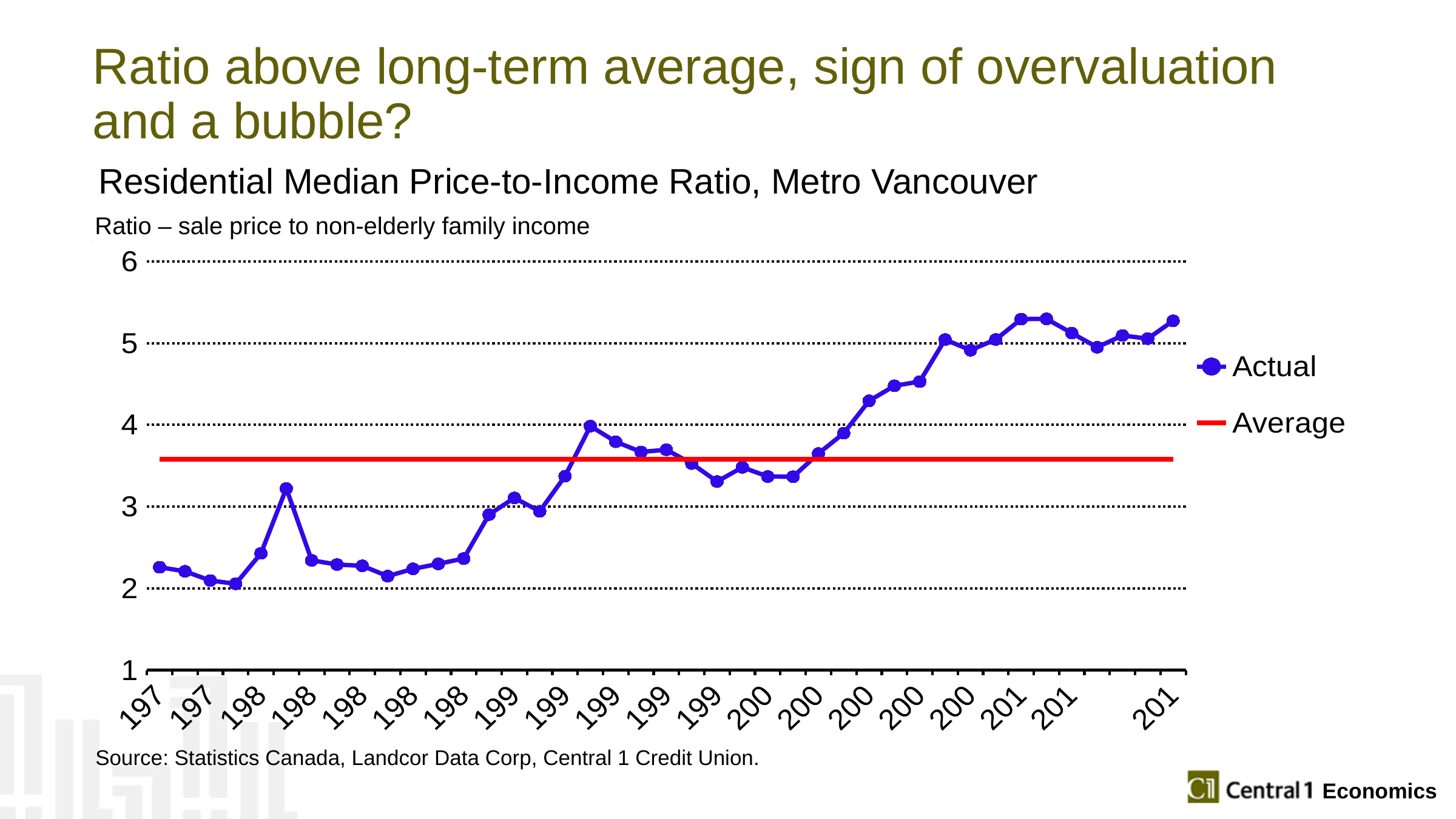
Does the Actual series generally rise or fall from the left of the x axis to the right? rise Is the rightmost Actual data point greater or less than 5? greater How many series does the chart's legend list? 2 What are the two series named in the legend? Actual and Average Is the highest value of the Actual series greater or less than 5? greater What kind of chart is shown on the slide? line chart Is the leftmost Actual data point greater or less than 3? less At the rightmost data point, is the Actual series above or below the Average line? above What is the highest tick value shown on the y axis? 6 What is the title of the chart? Residential Median Price-to-Income Ratio, Metro Vancouver